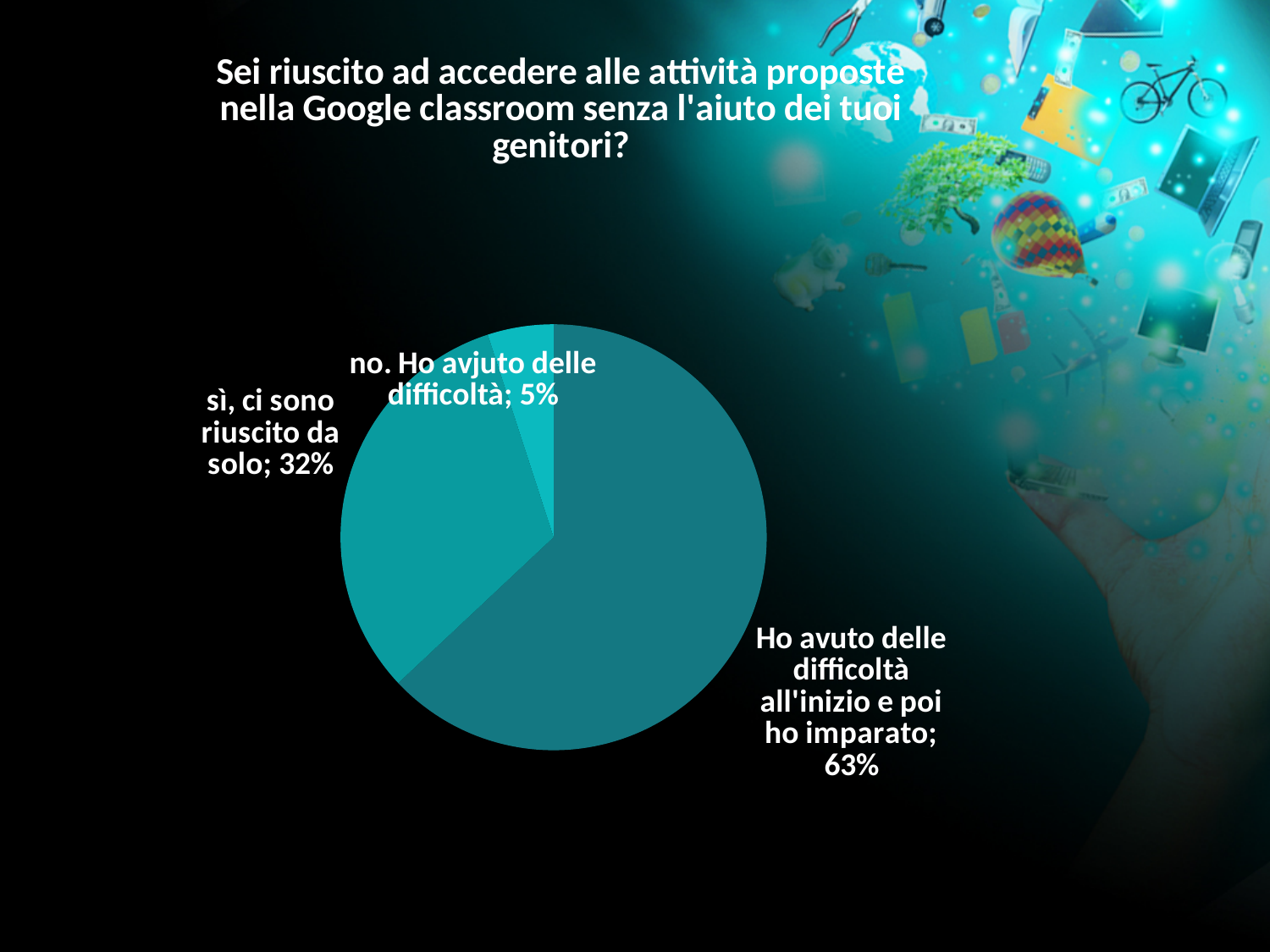
How many slices does the pie chart have? 3 What is the difference in percentage points between the "sì, ci sono riuscito da solo" slice and the "no. Ho avuto delle difficoltà" slice? 27 What is the title of the chart? Sei riuscito ad accedere alle attività proposte nella Google classroom senza l'aiuto dei tuoi genitori? What share of the pie is labelled "no. Ho avuto delle difficoltà"? 5% Which is larger: the "sì, ci sono riuscito da solo" slice or the "no. Ho avuto delle difficoltà" slice? sì, ci sono riuscito da solo What share of the pie is labelled "Ho avuto delle difficoltà all'inizio e poi ho imparato"? 63% What share of the pie is labelled "sì, ci sono riuscito da solo"? 32% Which slice of the pie is the largest? Ho avuto delle difficoltà all'inizio e poi ho imparato What is the difference in percentage points between the "Ho avuto delle difficoltà all'inizio e poi ho imparato" slice and the "sì, ci sono riuscito da solo" slice? 31 Is the share for "sì, ci sono riuscito da solo" greater or less than 50%? less Which slice of the pie is the smallest? no. Ho avjuto delle difficoltà What kind of chart is shown on the slide? pie chart